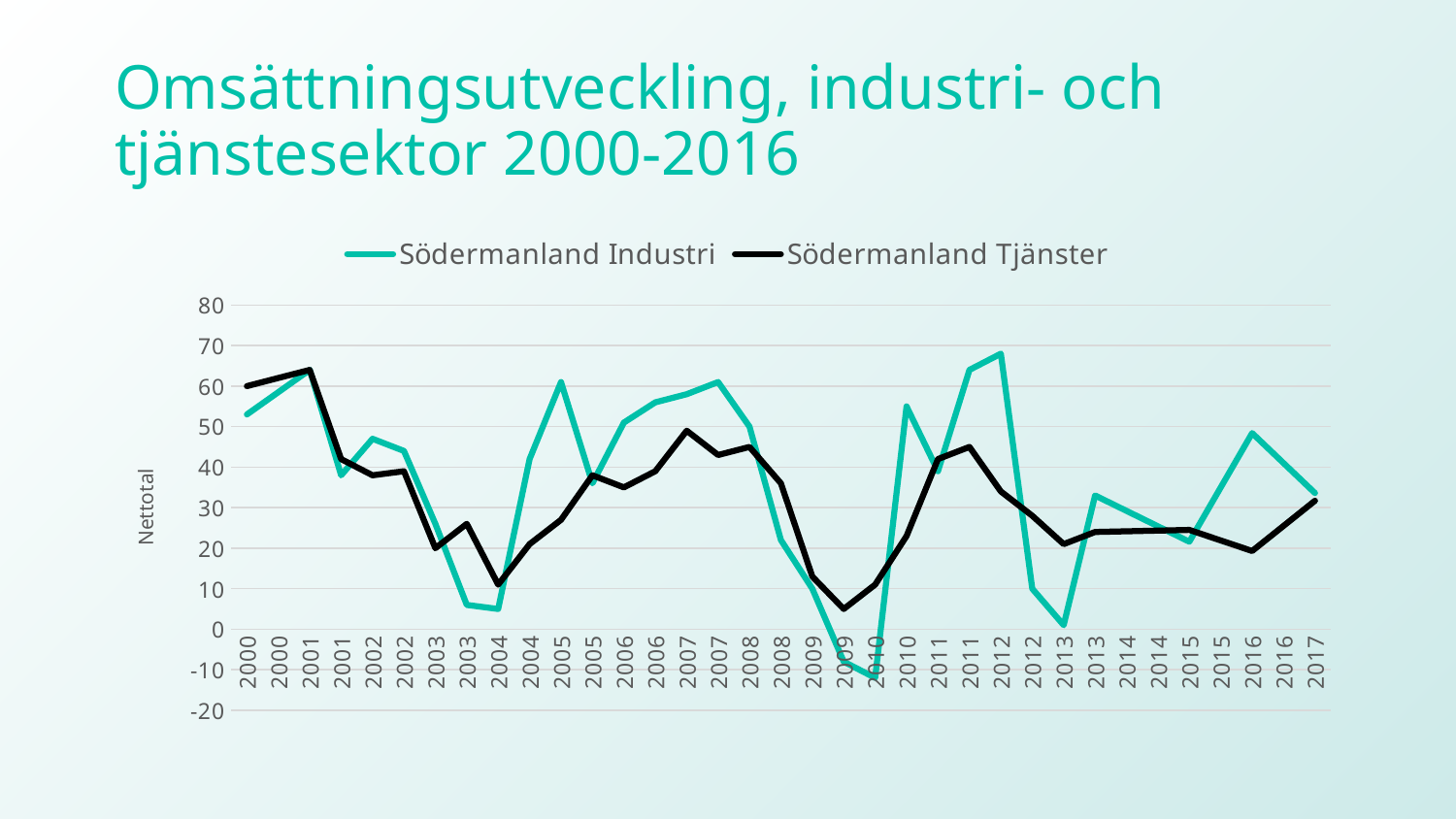
What is the label on the vertical axis? Nettotal How many series does the legend list? 2 In which year does Södermanland Tjänster reach its highest value? 2001 Is the value for Södermanland Industri at the first 2012 point greater or less than 60? greater Is the value for Södermanland Tjänster at the first 2001 point greater or less than 60? greater Is the value for Södermanland Industri at the second 2009 point greater or less than 0? less Does Södermanland Tjänster rise or fall from the first 2001 point to the first 2003 point? fall What kind of chart is shown on the slide? line chart In which year does Södermanland Industri reach its lowest value? 2010 At the first 2012 point, which series has the higher value, Södermanland Industri or Södermanland Tjänster? Södermanland Industri Which series is drawn with the black line? Södermanland Tjänster